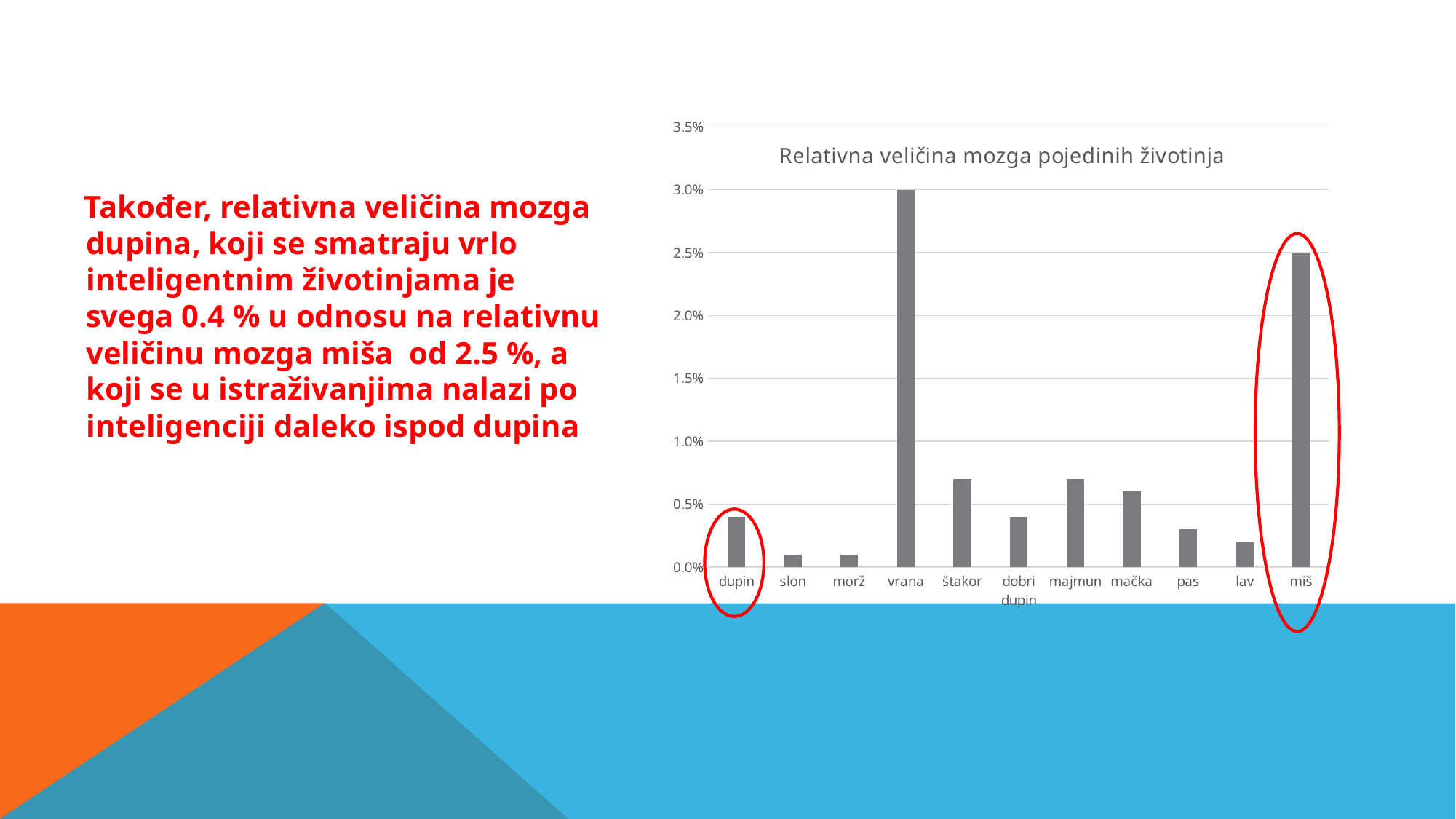
What is the relative brain size value for dupin? 0.4% Which animal has the highest relative brain size in the chart? vrana What is the difference between the values for vrana and miš? 0.5% Is the value for pas greater or less than 0.5%? less Is the value for štakor greater or less than 0.5%? greater What is the relative brain size value for miš? 2.5% What kind of chart is shown on the slide? bar chart What is the relative brain size value for vrana? 3.0% How many animal categories are shown on the x axis of the chart? 11 What is the title of the chart? Relativna veličina mozga pojedinih životinja Which is larger, the value for miš or the value for dupin? miš Which is larger, the value for vrana or the value for miš? vrana